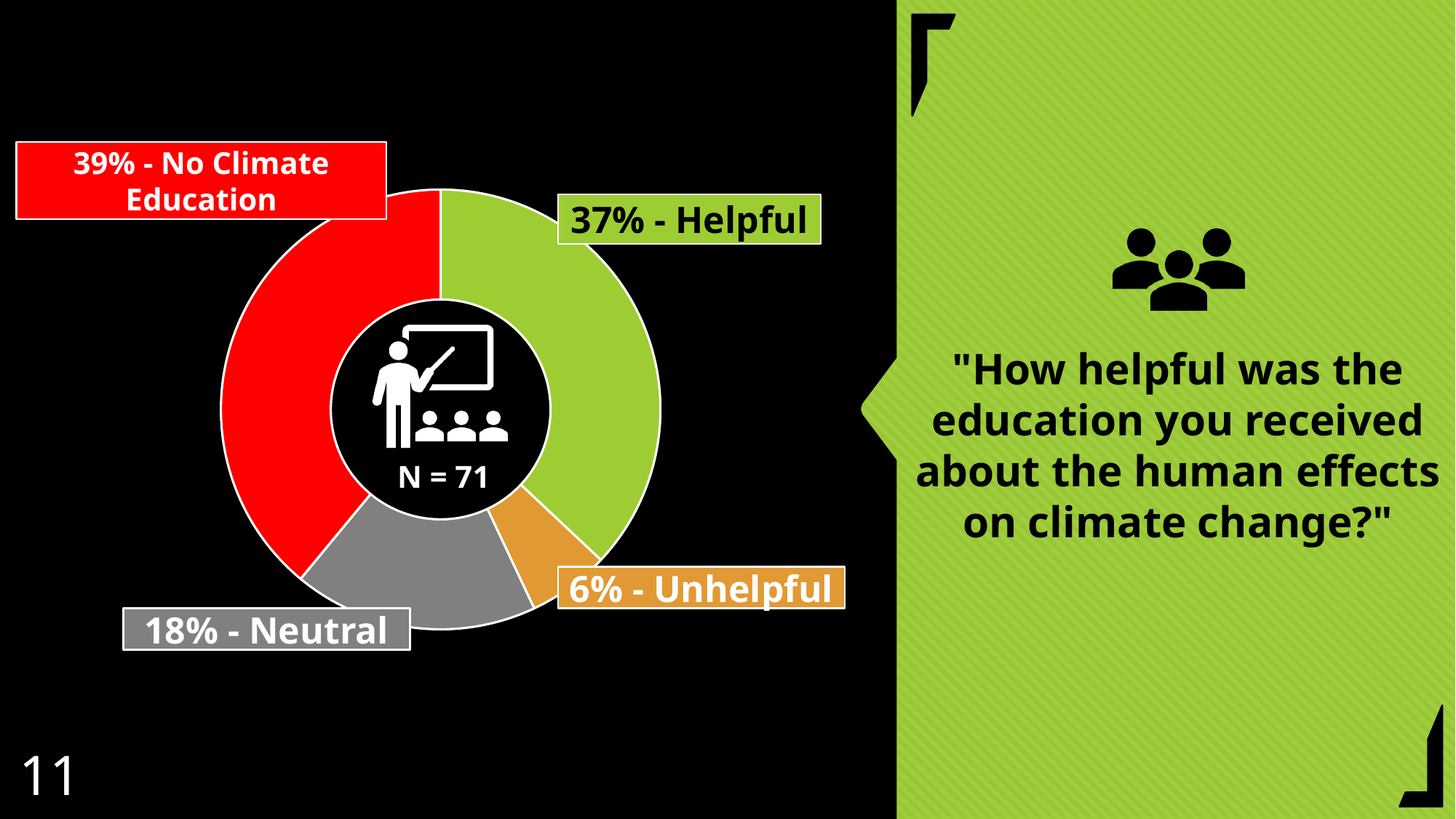
What percentage of respondents said the education they received was helpful? 37% What percentage of respondents found the education unhelpful? 6% What kind of chart is shown on the slide? Pie chart (doughnut) What is the sample size (N) shown in the centre of the chart? N = 71 What is the difference in percentage points between the Helpful and Unhelpful shares? 31 Which is larger, the Neutral share or the Unhelpful share? Neutral What percentage of respondents reported having no climate education? 39% How many categories are shown in the chart? 4 What share of the pie is labelled Neutral? 18% Which category has the smallest share of the pie? Unhelpful What colour is the slice representing No Climate Education? Red Which category has the largest share of the pie? No Climate Education